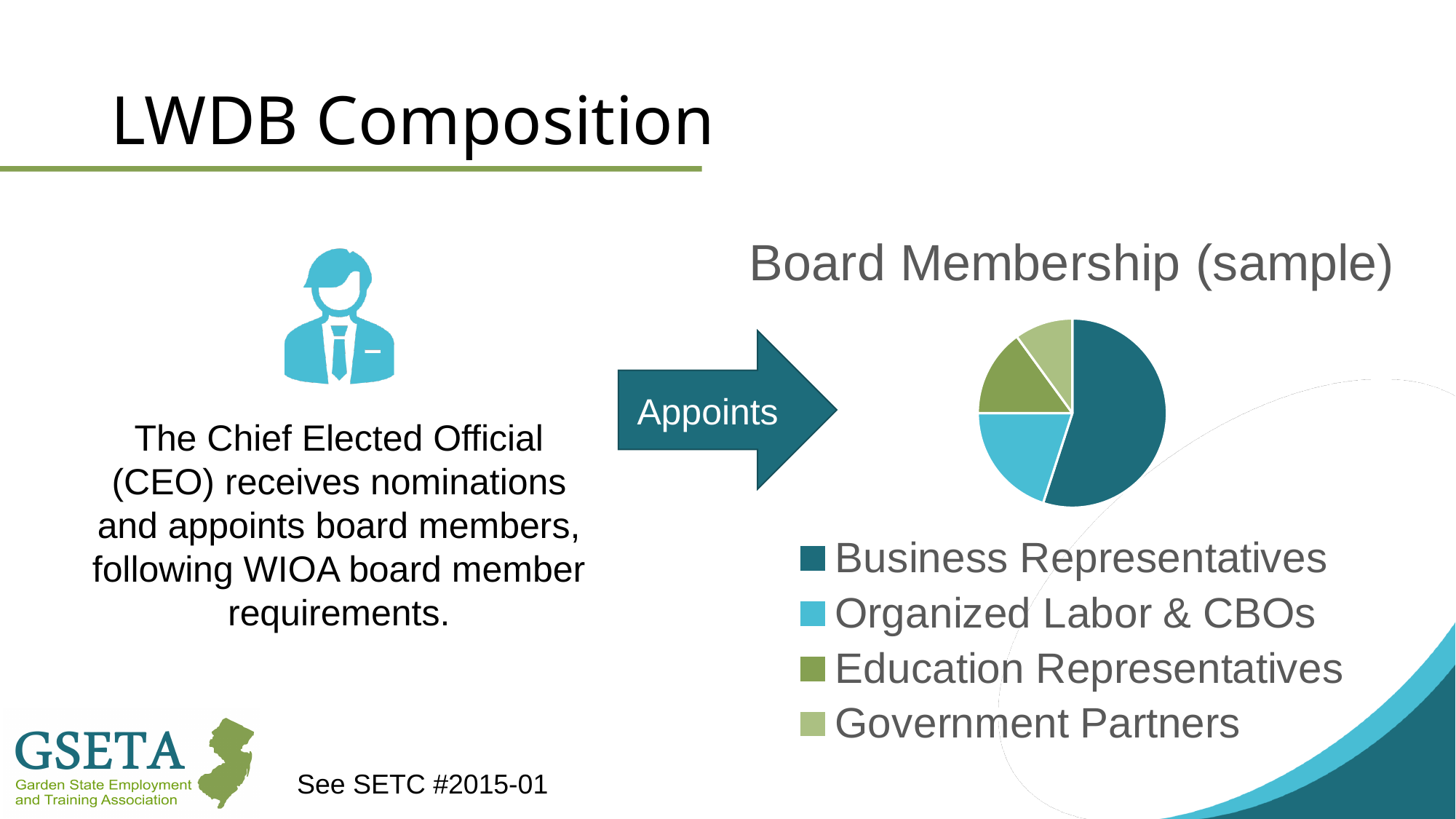
How many entries does the legend of the Board Membership (sample) chart list? 4 What is the title of the pie chart on the slide? Board Membership (sample) In the Board Membership (sample) pie chart, which slice is larger: Education Representatives or Government Partners? Education Representatives Which category has the largest slice in the Board Membership (sample) pie chart? Business Representatives In the Board Membership (sample) pie chart, which slice is larger: Business Representatives or Government Partners? Business Representatives What kind of chart is shown under the title "Board Membership (sample)"? pie chart How many slices does the Board Membership (sample) pie chart have? 4 In the Board Membership (sample) pie chart, which slice is larger: Organized Labor & CBOs or Government Partners? Organized Labor & CBOs Which legend entry in the Board Membership (sample) chart is shown in light blue? Organized Labor & CBOs Which category has the smallest slice in the Board Membership (sample) pie chart? Government Partners